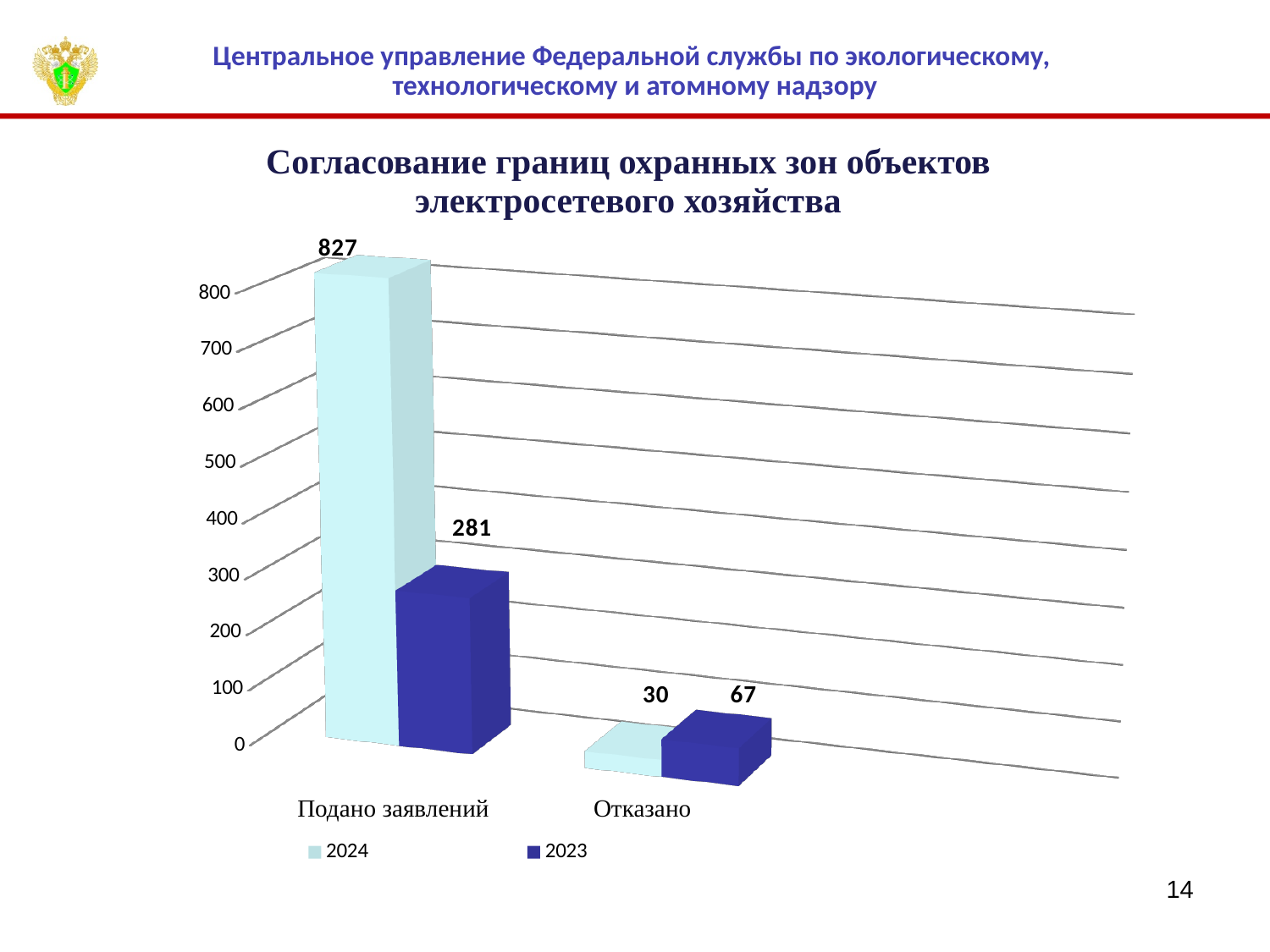
What kind of chart is shown on the slide? Bar chart Which category has the highest value for the 2024 series? Подано заявлений In the "Отказано" category, which series has the larger value, 2024 or 2023? 2023 What is the value for 2023 in the "Отказано" category? 67 What is the value for 2024 in the "Отказано" category? 30 How many series does the legend list? 2 What is the value for 2024 in the "Подано заявлений" category? 827 What is the difference between the 2023 and 2024 values for "Отказано"? 37 What is the difference between the 2024 and 2023 values for "Подано заявлений"? 546 How many categories are shown on the x axis? 2 Which category has the lowest value for the 2023 series? Отказано What is the value for 2023 in the "Подано заявлений" category? 281